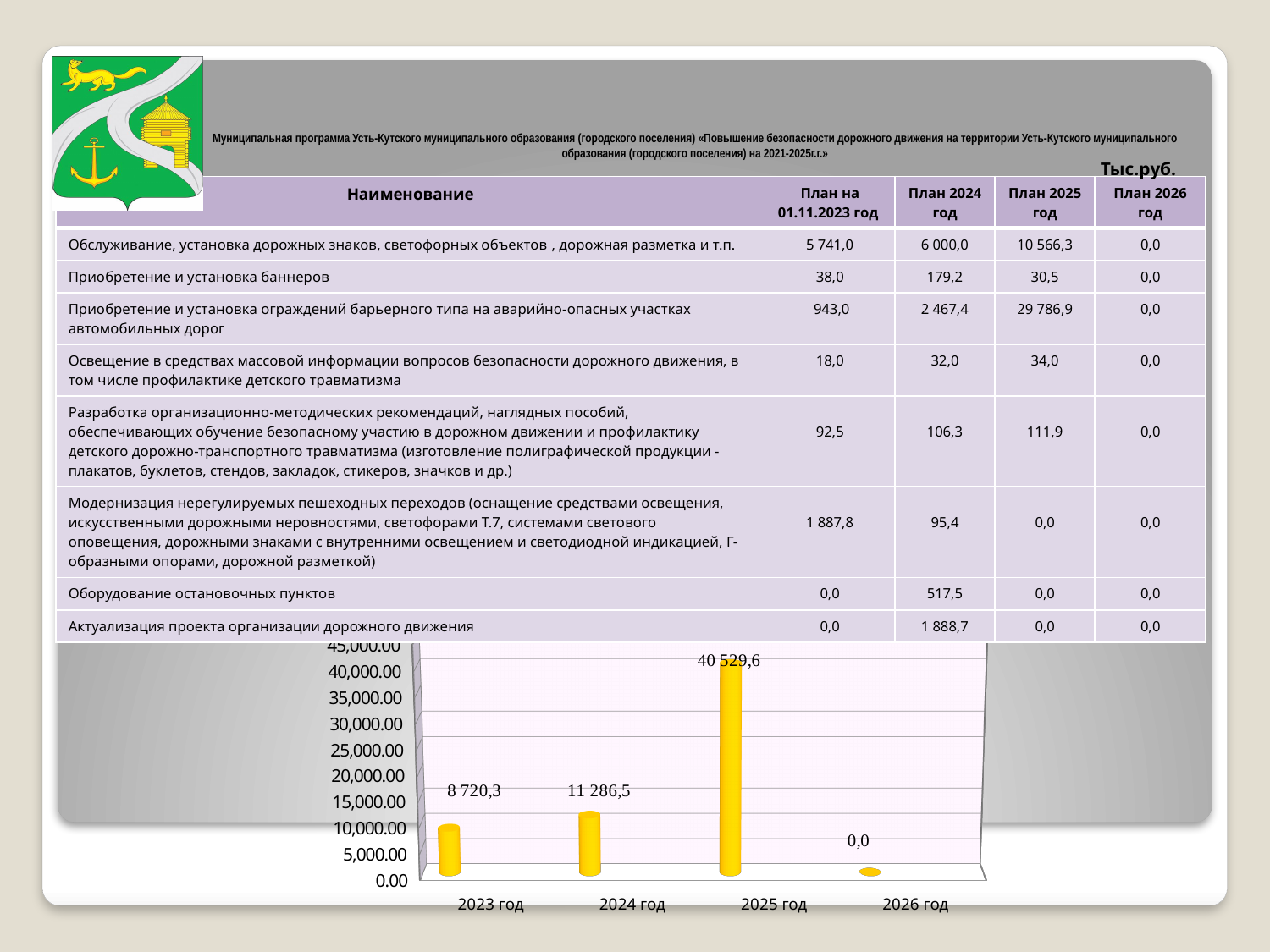
What is the difference between the values for 2024 год and 2023 год in the bar chart? 2 566,2 Which year has the lowest value in the bar chart? 2026 год Which is larger in the bar chart, the value for 2023 год or the value for 2024 год? 2024 год What kind of chart is shown at the bottom of the slide? bar chart What is the value shown for 2026 год in the bar chart? 0,0 Which year has the highest value in the bar chart? 2025 год What is the value shown for 2025 год in the bar chart? 40 529,6 How many years are shown on the x axis of the bar chart? 4 What is the value shown for 2023 год in the bar chart? 8 720,3 What is the difference between the values for 2025 год and 2024 год in the bar chart? 29 243,1 What is the value shown for 2024 год in the bar chart? 11 286,5 Is the value for 2025 год in the bar chart greater or less than 35,000.00? greater